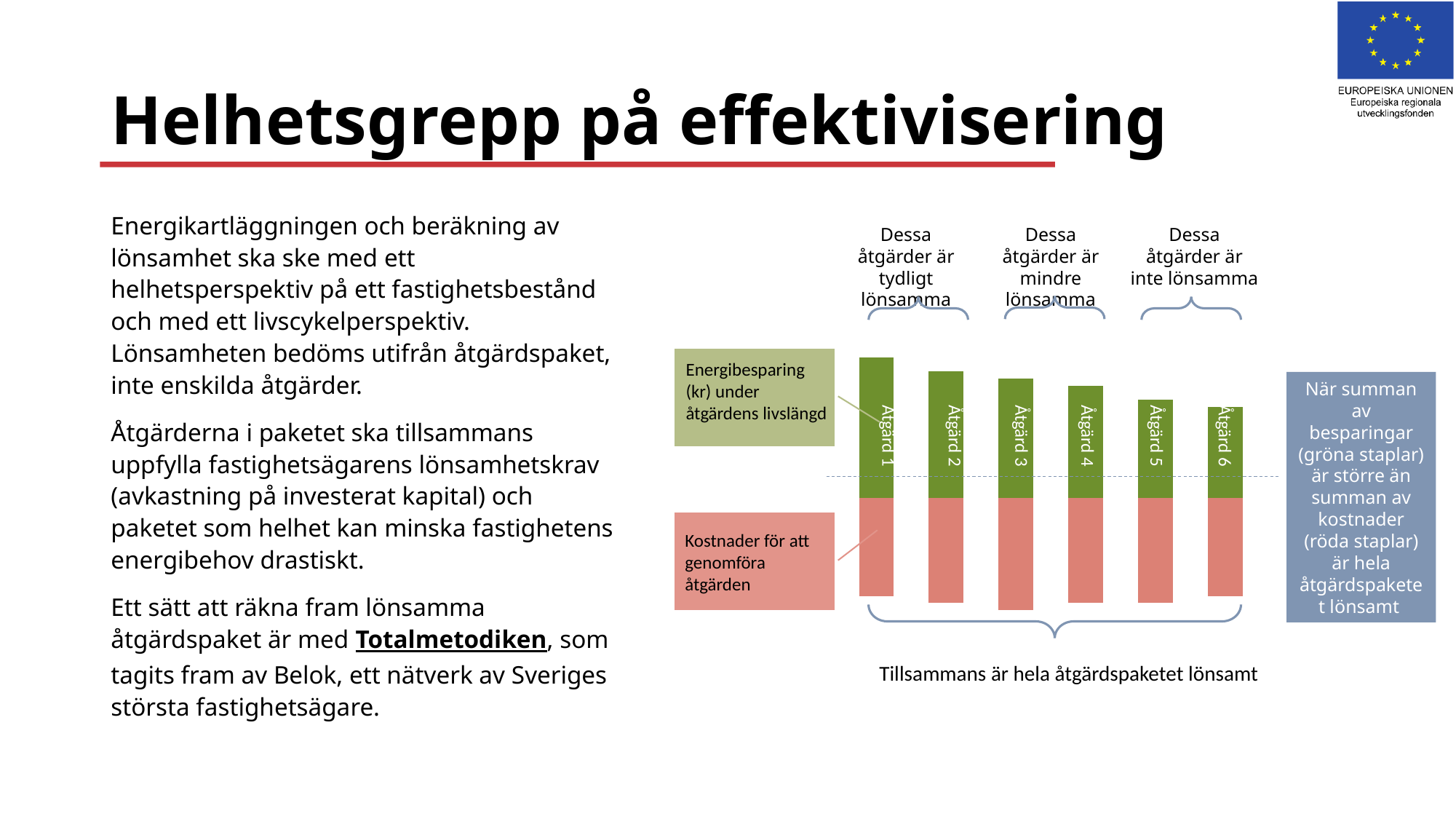
Which åtgärd has the tallest green (Energibesparing) segment? Åtgärd 1 Is the green segment for Åtgärd 2 larger or smaller than the green segment for Åtgärd 5? Larger How many series are shown in the stacked bars of the chart? 2 Which åtgärder are labelled as 'tydligt lönsamma' in the chart? Åtgärd 1 and Åtgärd 2 What does the red part of each bar represent according to the chart? Kostnader för att genomföra åtgärden Which åtgärd has the shortest green (Energibesparing) segment? Åtgärd 6 Which åtgärder are labelled as 'inte lönsamma' in the chart? Åtgärd 5 and Åtgärd 6 What kind of chart is shown on the right side of the slide? Stacked bar chart Which åtgärd has the tallest bar overall? Åtgärd 1 What does the green part of each bar represent according to the chart? Energibesparing (kr) under åtgärdens livslängd Do the green (Energibesparing) segments rise or fall from Åtgärd 1 to Åtgärd 6? Fall How many bars (åtgärder) are shown in the chart? 6